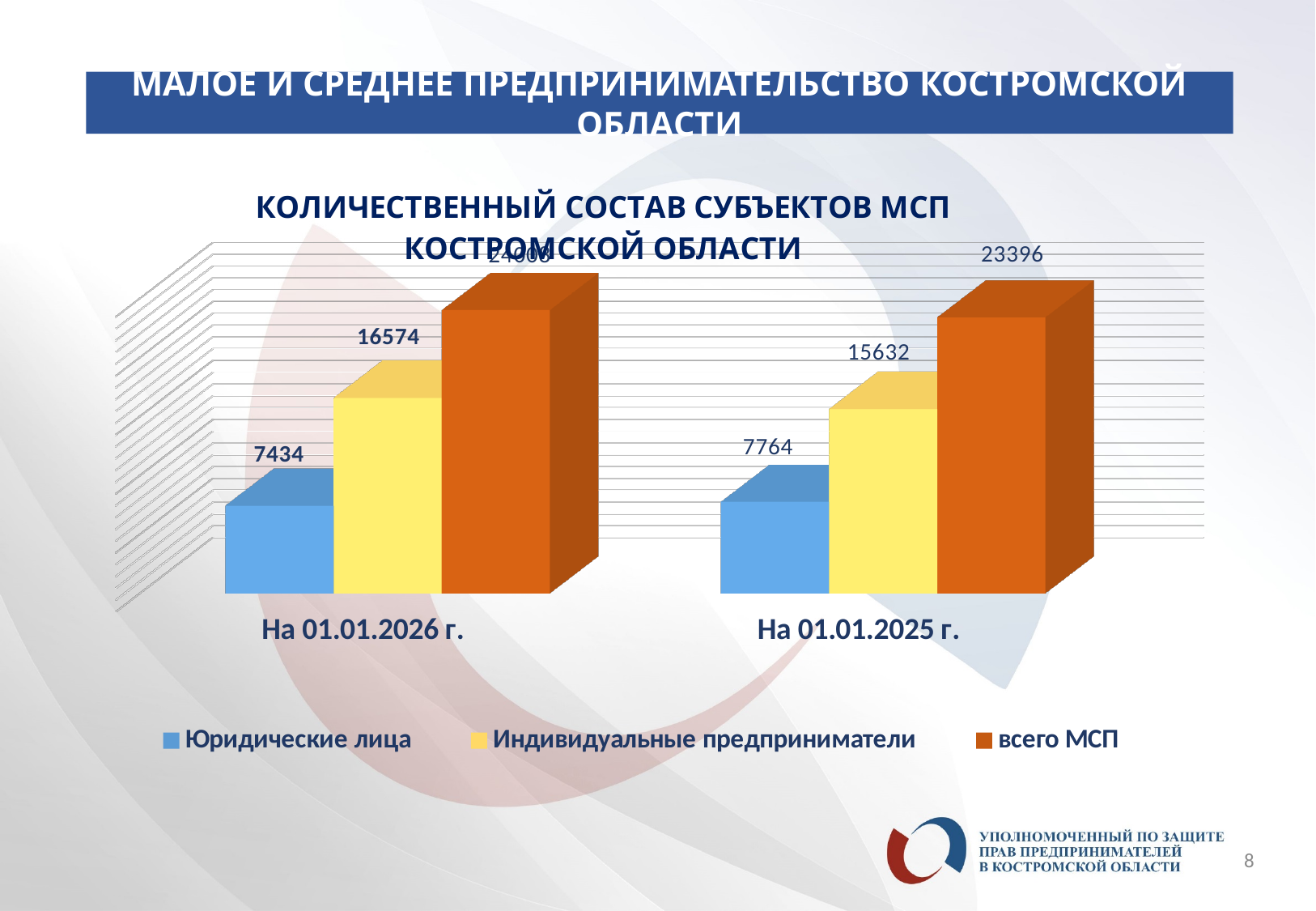
Which date has the larger value for Юридические лица, 01.01.2026 or 01.01.2025? На 01.01.2025 г. How many series does the legend list? 3 What is the value for всего МСП on 01.01.2025? 23396 What is the value for Юридические лица on 01.01.2026? 7434 What is the value for Индивидуальные предприниматели on 01.01.2025? 15632 What is the difference between the values for Юридические лица on 01.01.2025 and on 01.01.2026? 330 Which series has the highest value on 01.01.2025? всего МСП How many categories (dates) are shown on the x axis? 2 What kind of chart is shown on the slide? Bar chart By how much does the value for Индивидуальные предприниматели on 01.01.2026 exceed the value on 01.01.2025? 942 What is the value for Индивидуальные предприниматели on 01.01.2026? 16574 What is the value for Юридические лица on 01.01.2025? 7764